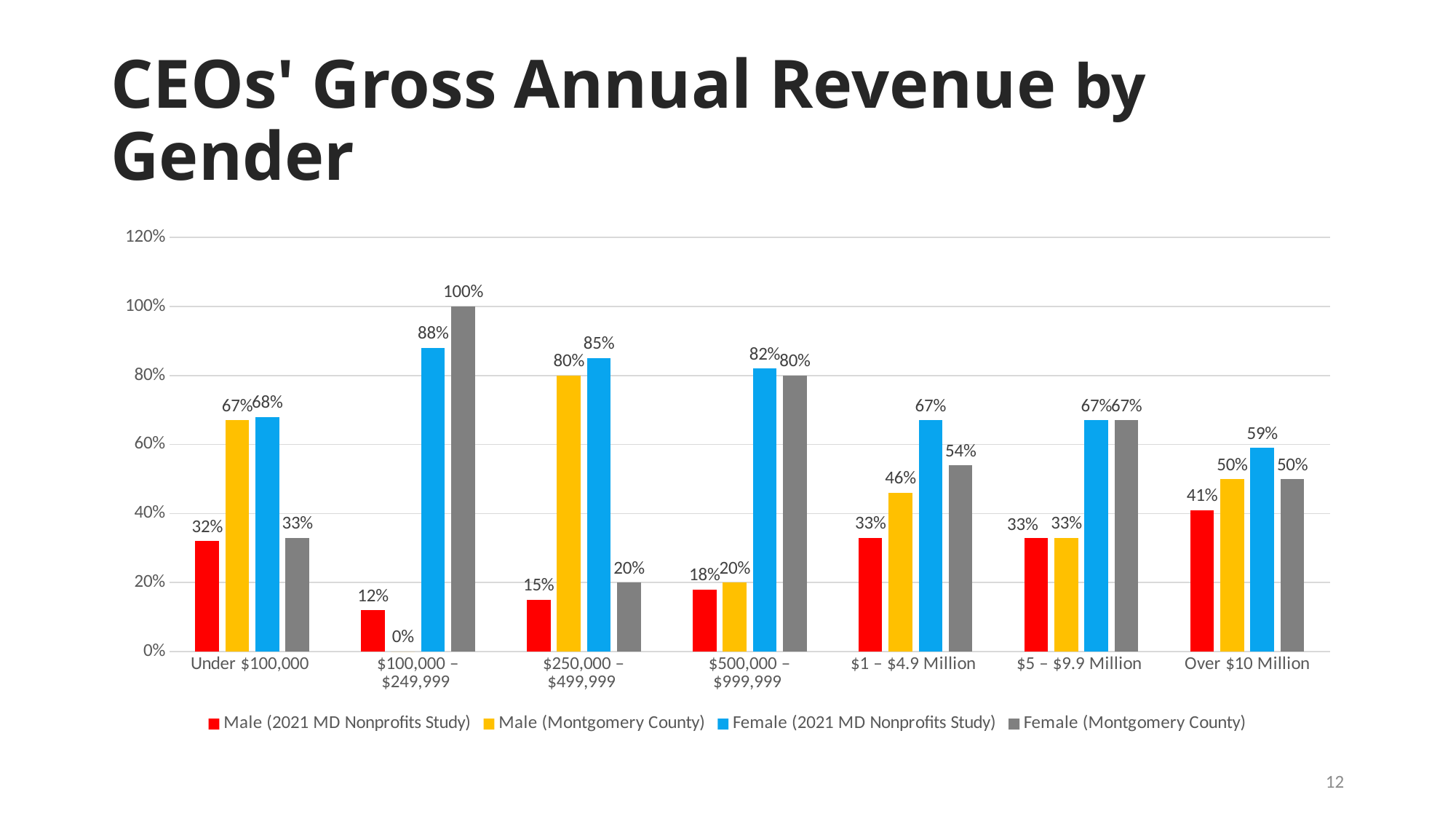
What is the value for Male (2021 MD Nonprofits Study) in the Over $10 Million category? 41% Which colour represents Female (2021 MD Nonprofits Study) in the chart? Blue How many revenue categories are shown on the x axis? 7 Which revenue category has the highest value for Female (2021 MD Nonprofits Study)? $100,000 – $249,999 What kind of chart is shown on the slide? Bar chart Which revenue category has the lowest value for Male (Montgomery County)? $100,000 – $249,999 What is the difference between the Female (2021 MD Nonprofits Study) and Male (2021 MD Nonprofits Study) values in the $1 – $4.9 Million category? 34% What is the value for Female (Montgomery County) in the $100,000 – $249,999 category? 100% In the $500,000 – $999,999 category, which is larger: Female (2021 MD Nonprofits Study) or Female (Montgomery County)? Female (2021 MD Nonprofits Study) What is the value for Male (Montgomery County) in the $250,000 – $499,999 category? 80% Is the value for Male (Montgomery County) in the $1 – $4.9 Million category greater or less than 40%? greater How many series does the legend list? 4